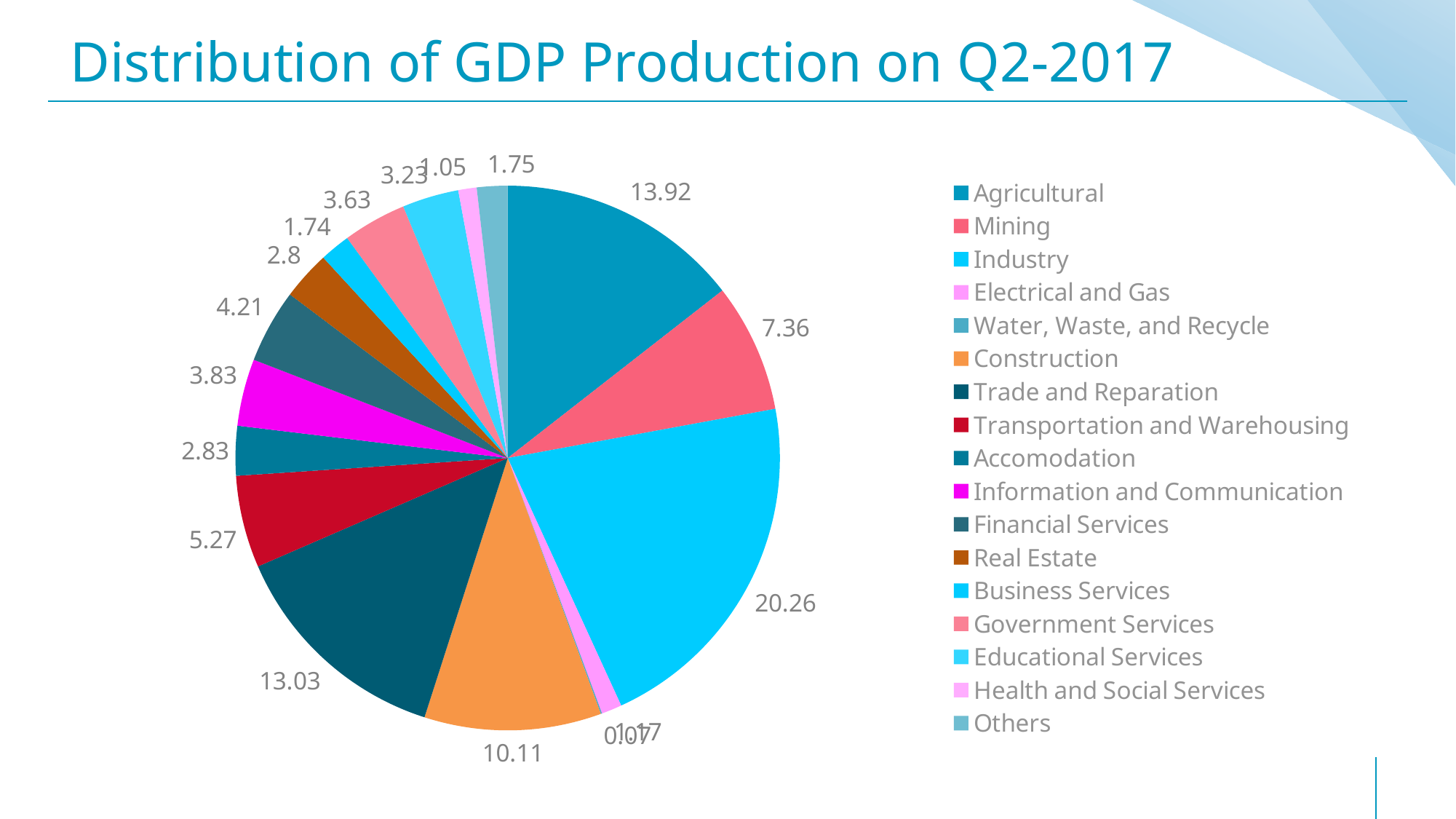
Which is larger, Construction or Trade and Reparation? Trade and Reparation What is the value for Financial Services? 4.21 What is the difference between the values for Industry and Agricultural? 6.34 What is the value for Transportation and Warehousing? 5.27 Which category has the largest slice? Industry What is the value for Agricultural? 13.92 What is the value for Construction? 10.11 What is the title of the chart? Distribution of GDP Production on Q2-2017 What is the value for Trade and Reparation? 13.03 What is the value for Industry? 20.26 What type of chart is shown on the slide? pie chart How many categories does the legend list? 17